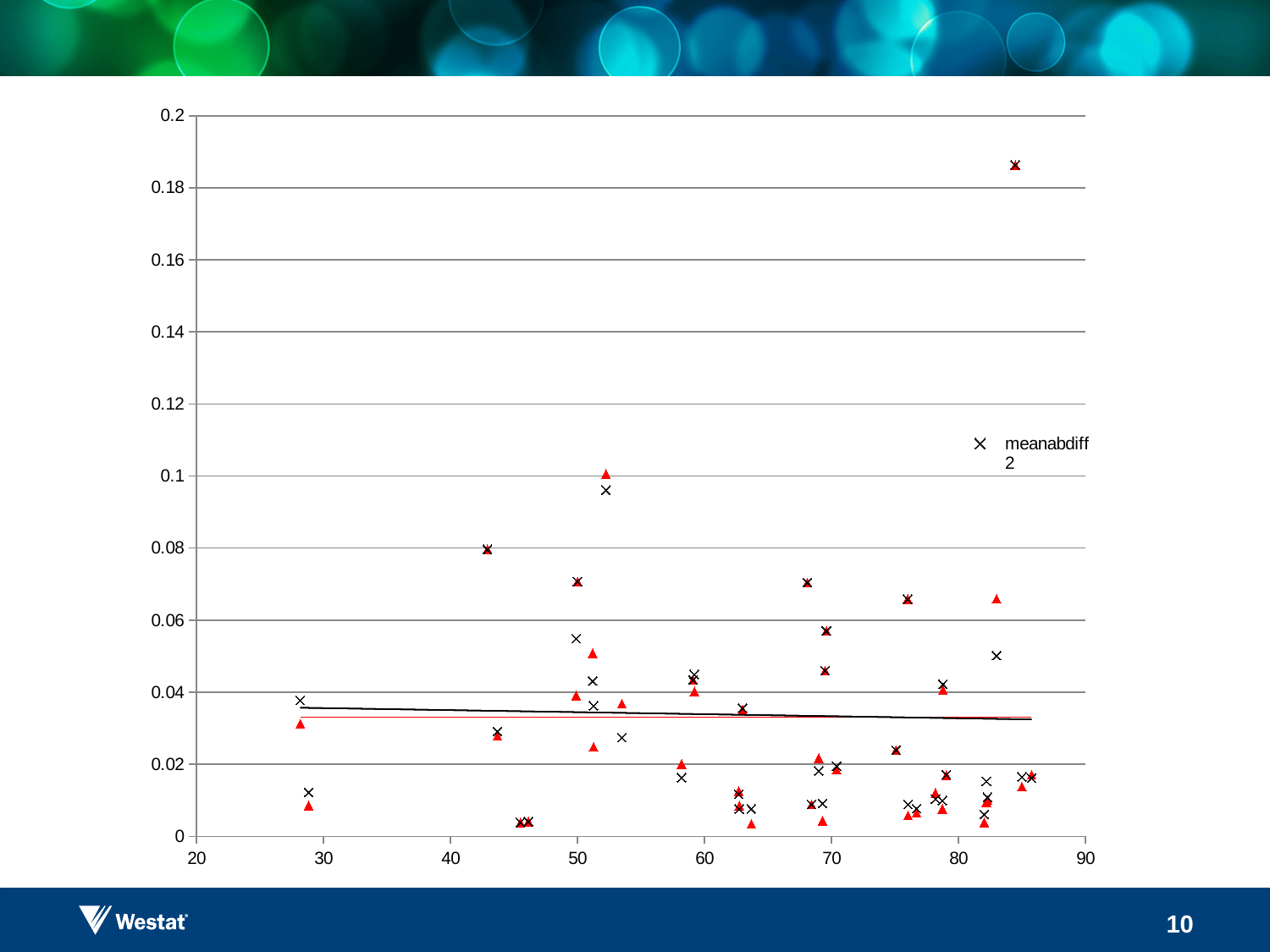
Is the meanabdiff point near x = 83 (around 0.05) greater or less than 0.04? greater Does the fitted trend line rise or fall from left to right? fall Is the meanabdiff point near x = 43 greater or less than 0.06? greater Is the red triangle point near x = 52 greater or less than 0.08? greater How many series does the legend list? 1 What is the maximum value shown on the y axis? 0.2 What kind of chart is shown on the slide? scatter chart Which marker symbol is used for the meanabdiff series? x